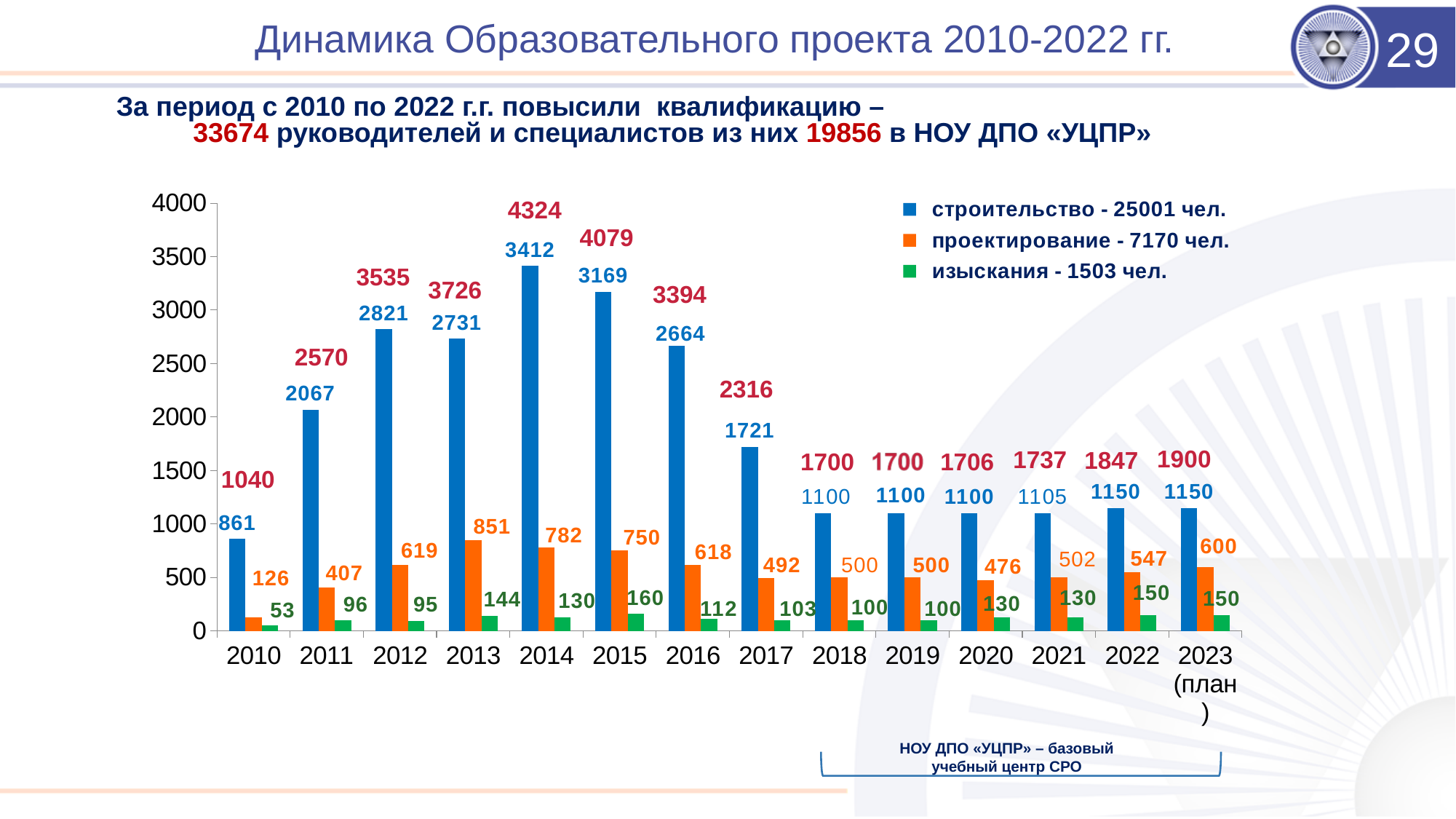
In which year is the строительство value highest? 2014 In which year is the изыскания value lowest? 2010 What is the difference between the строительство values for 2012 and 2013? 90 How many series does the legend list? 3 According to the legend, what is the total number of people for проектирование? 7170 чел. What type of chart is shown on the slide? bar chart How many year categories are shown on the x axis? 14 Which is larger, the проектирование value in 2016 or in 2012? 2012 What is the value for проектирование in 2013? 851 What is the value for строительство in 2014? 3412 What is the value for изыскания in 2015? 160 Is the строительство value for 2017 greater or less than 1500? greater